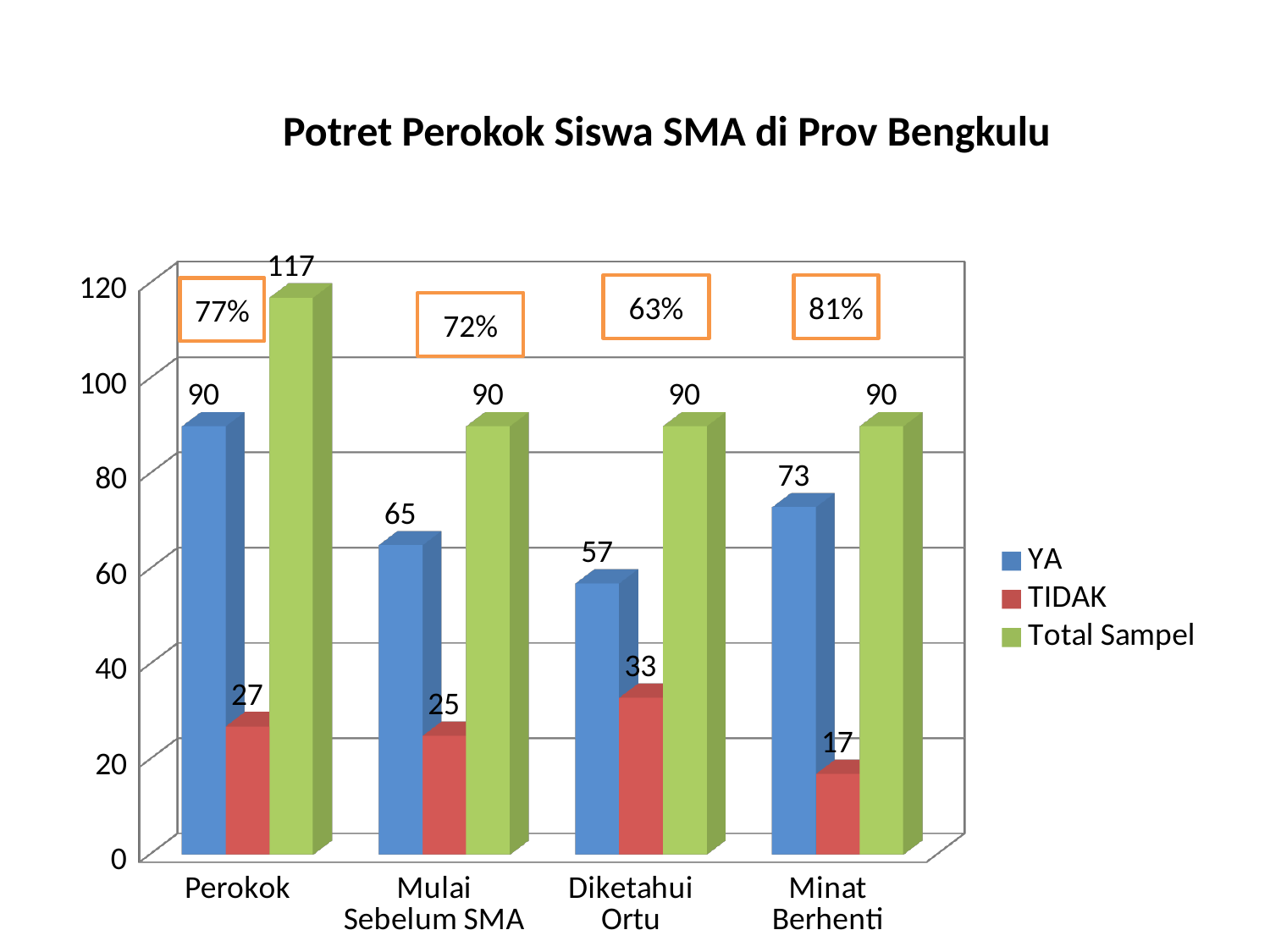
Which category has the highest TIDAK value? Diketahui Ortu Is the TIDAK value for Perokok larger than the TIDAK value for Minat Berhenti? Yes What is the difference between the YA and TIDAK values for Mulai Sebelum SMA? 40 What kind of chart is shown? Bar chart What is the TIDAK value for Diketahui Ortu? 33 How many categories are shown on the x axis? 4 What is the YA value for Perokok? 90 What is the YA value for Minat Berhenti? 73 How many series does the legend list? 3 Which category has the lowest YA value? Diketahui Ortu What is the Total Sampel value for Perokok? 117 What is the title of the chart? Potret Perokok Siswa SMA di Prov Bengkulu